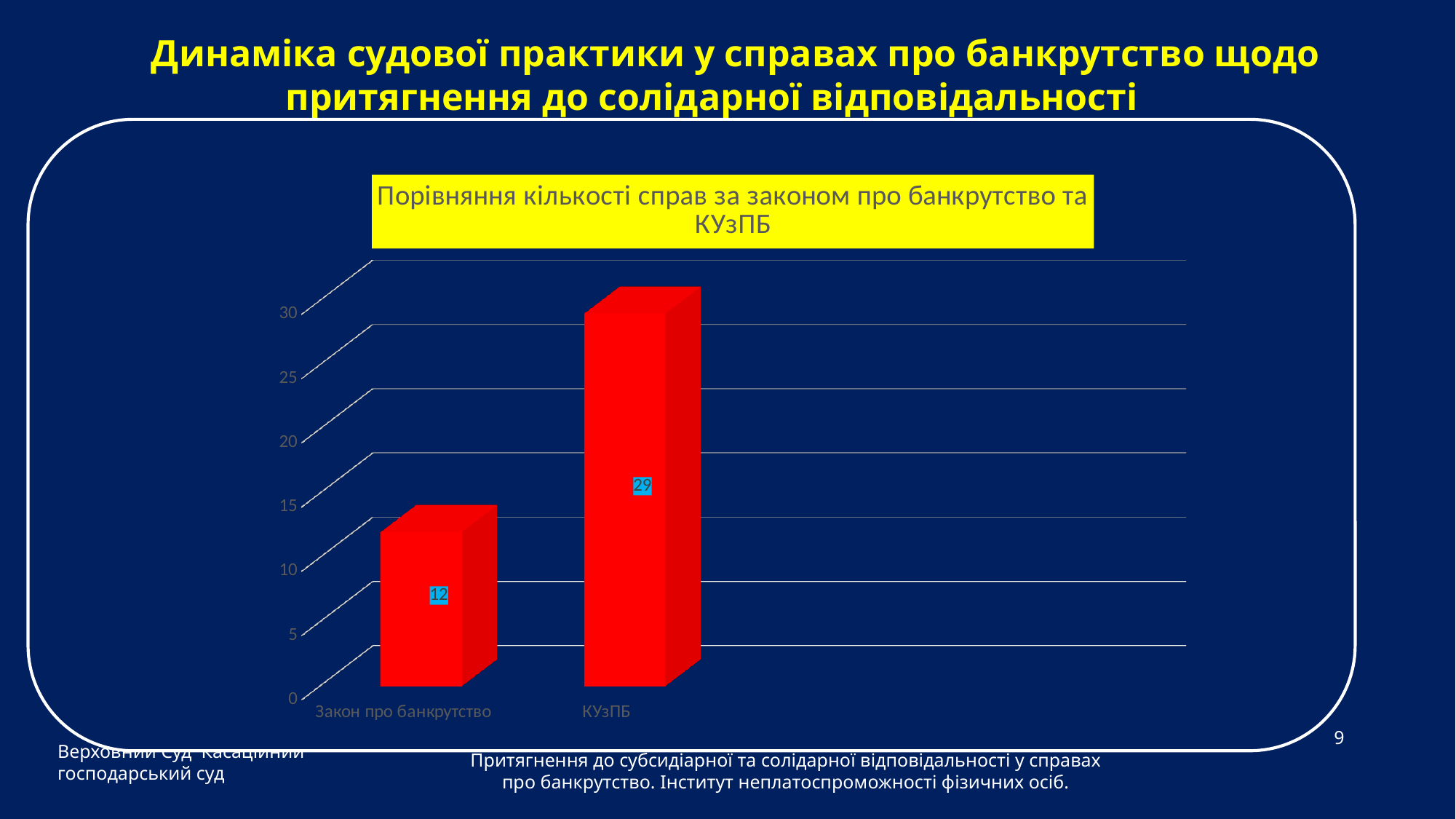
Which category has the highest value? КУзПБ What is the value for КУзПБ? 29 What is the value for Закон про банкрутство? 12 Is the value for Закон про банкрутство greater or less than 15? less Is the value for КУзПБ greater or less than 25? greater What is the difference between the values for КУзПБ and Закон про банкрутство? 17 How many categories are shown on the chart? 2 Which category has the lowest value? Закон про банкрутство What is the title of the chart? Порівняння кількості справ за законом про банкрутство та КУзПБ What kind of chart is shown on the slide? Bar chart What colour are the bars in the chart? Red Which is larger, the value for Закон про банкрутство or the value for КУзПБ? КУзПБ